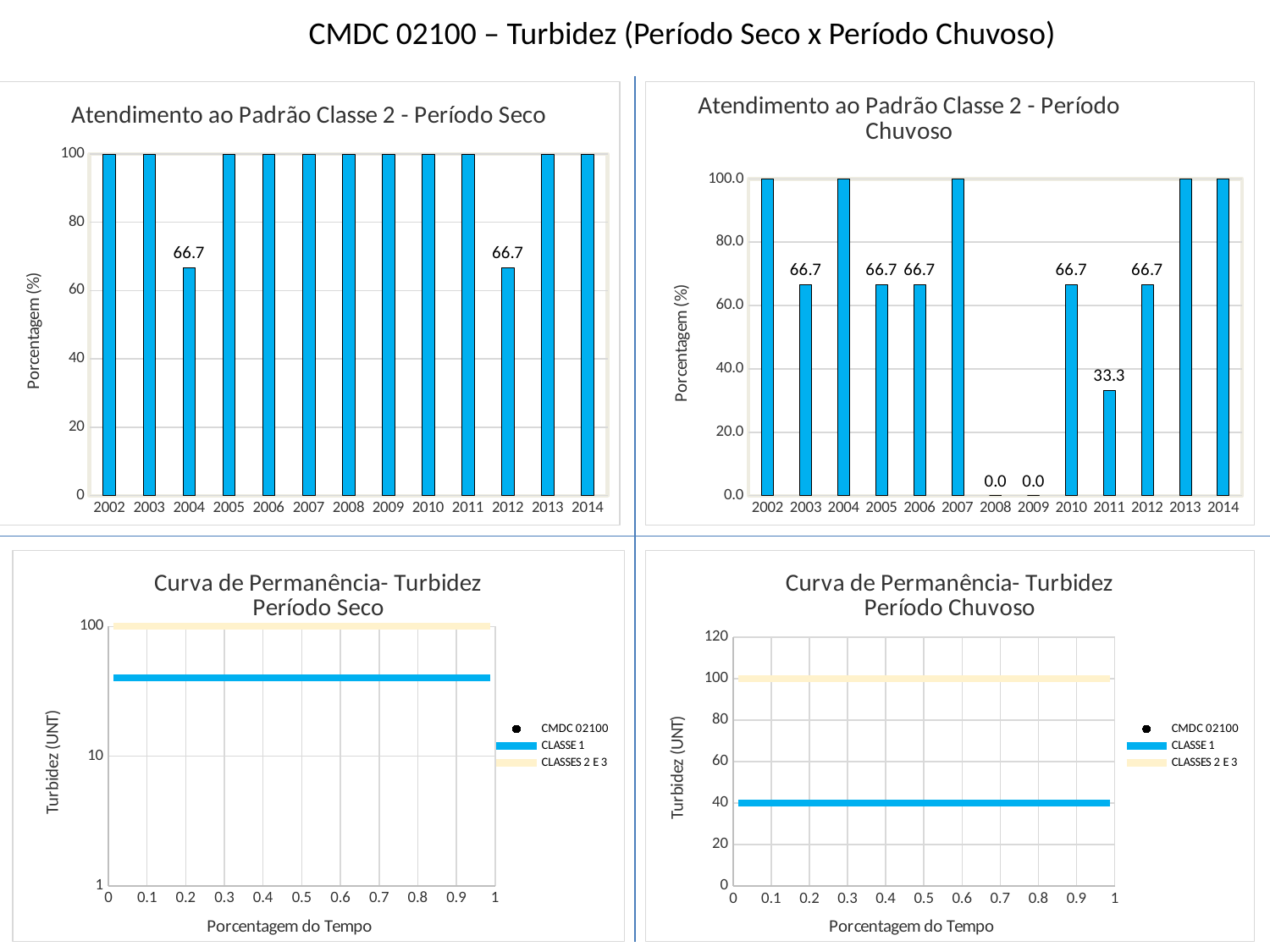
In the 'Atendimento ao Padrão Classe 2 - Período Chuvoso' chart, what is the value for 2008? 0.0 In the 'Atendimento ao Padrão Classe 2 - Período Chuvoso' chart, which years have the lowest value? 2008 and 2009 How many years are shown on the x axis of the 'Atendimento ao Padrão Classe 2 - Período Seco' chart? 13 In the 'Atendimento ao Padrão Classe 2 - Período Seco' chart, is the value for 2002 greater or less than 80? greater What kind of chart is 'Atendimento ao Padrão Classe 2 - Período Seco'? bar chart In the 'Atendimento ao Padrão Classe 2 - Período Chuvoso' chart, which year has the larger value, 2003 or 2011? 2003 In the 'Atendimento ao Padrão Classe 2 - Período Seco' chart, what is the value for 2004? 66.7 In the 'Atendimento ao Padrão Classe 2 - Período Chuvoso' chart, how many years have a value of 66.7? 5 What is the x-axis title of the 'Curva de Permanência- Turbidez Período Chuvoso' chart? Porcentagem do Tempo In the 'Atendimento ao Padrão Classe 2 - Período Chuvoso' chart, what is the value for 2011? 33.3 In the 'Atendimento ao Padrão Classe 2 - Período Chuvoso' chart, what is the difference between the values for 2010 and 2011? 33.4 How many series does the legend of the 'Curva de Permanência- Turbidez Período Seco' chart list? 3